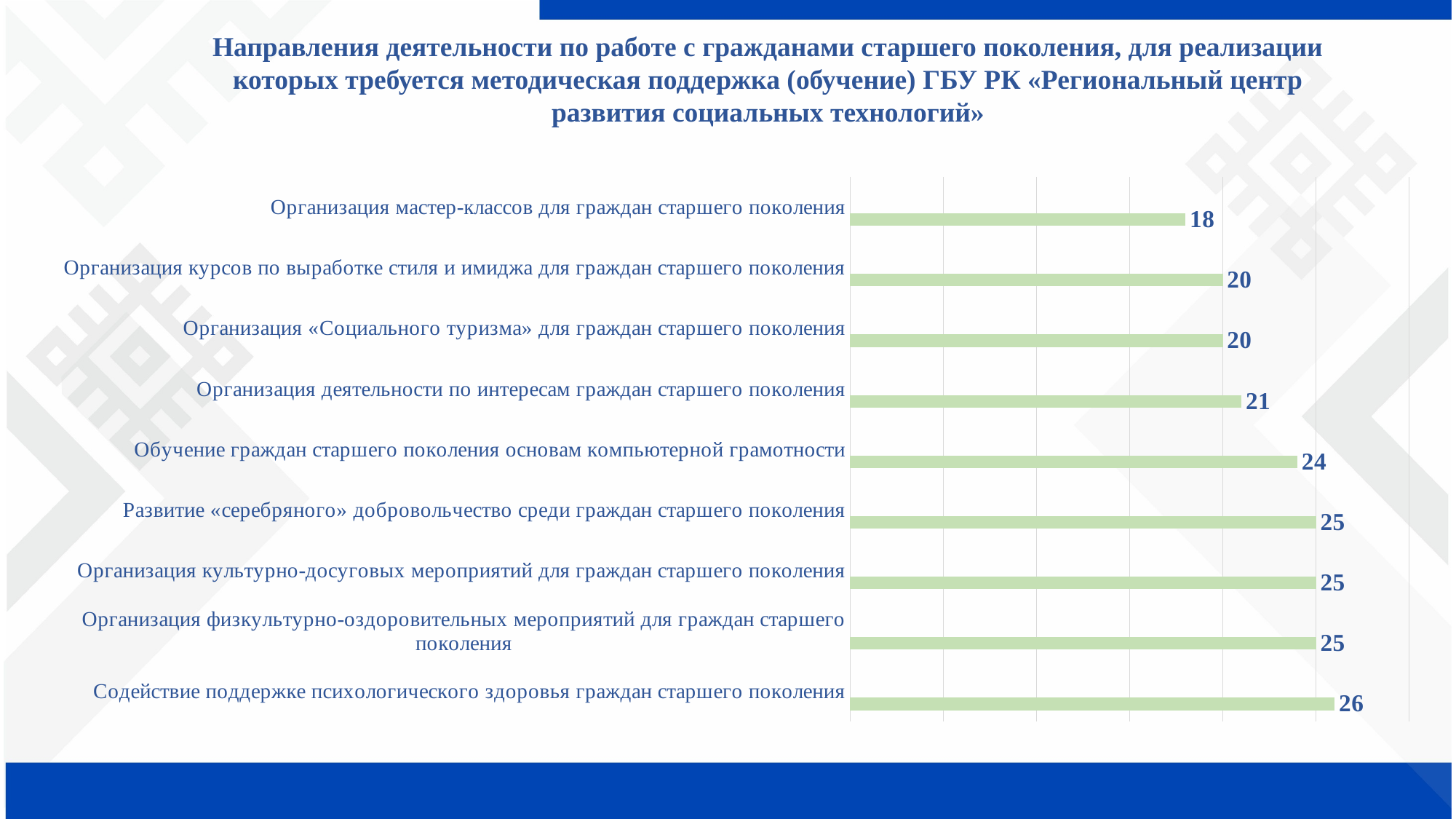
Which category has the highest value? Содействие поддержке психологического здоровья граждан старшего поколения How many categories share the value 25? 3 What value is shown for «Обучение граждан старшего поколения основам компьютерной грамотности»? 24 Which category has the lowest value? Организация мастер-классов для граждан старшего поколения What value is shown for «Организация мастер-классов для граждан старшего поколения»? 18 What kind of chart is shown on the slide? Bar chart What value is shown for «Организация деятельности по интересам граждан старшего поколения»? 21 What is the difference between the highest value (26) and the lowest value (18)? 8 Which is larger: the value for «Развитие «серебряного» добровольчество среди граждан старшего поколения» or the value for «Организация деятельности по интересам граждан старшего поколения»? Развитие «серебряного» добровольчество среди граждан старшего поколения What is the difference between the value for «Обучение граждан старшего поколения основам компьютерной грамотности» and the value for «Организация «Социального туризма» для граждан старшего поколения»? 4 How many categories are shown in the chart? 9 What value is shown for «Содействие поддержке психологического здоровья граждан старшего поколения»? 26